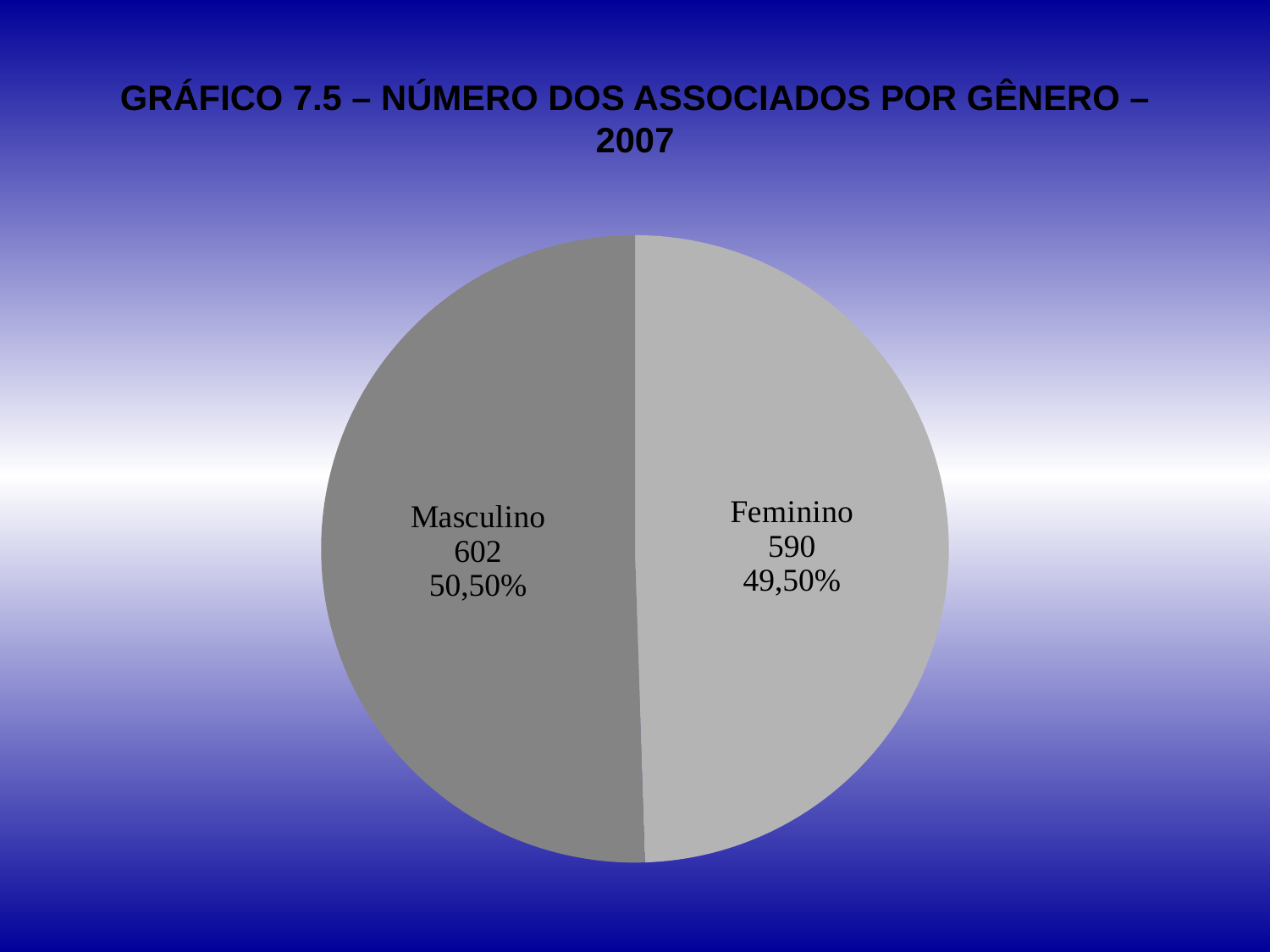
What is the difference between the number of Masculino and Feminino associates? 12 What is the number of associates for Masculino? 602 Which gender has the smaller number of associates? Feminino Which gender has the larger number of associates? Masculino How many slices does the pie chart have? 2 Is the value for Feminino larger or smaller than the value for Masculino? smaller What kind of chart is shown on the slide? pie chart What year does the chart title refer to? 2007 What share of the pie does the Masculino slice represent? 50,50% What share of the pie does the Feminino slice represent? 49,50% What is the total number of associates shown in the pie chart? 1192 What is the number of associates for Feminino? 590